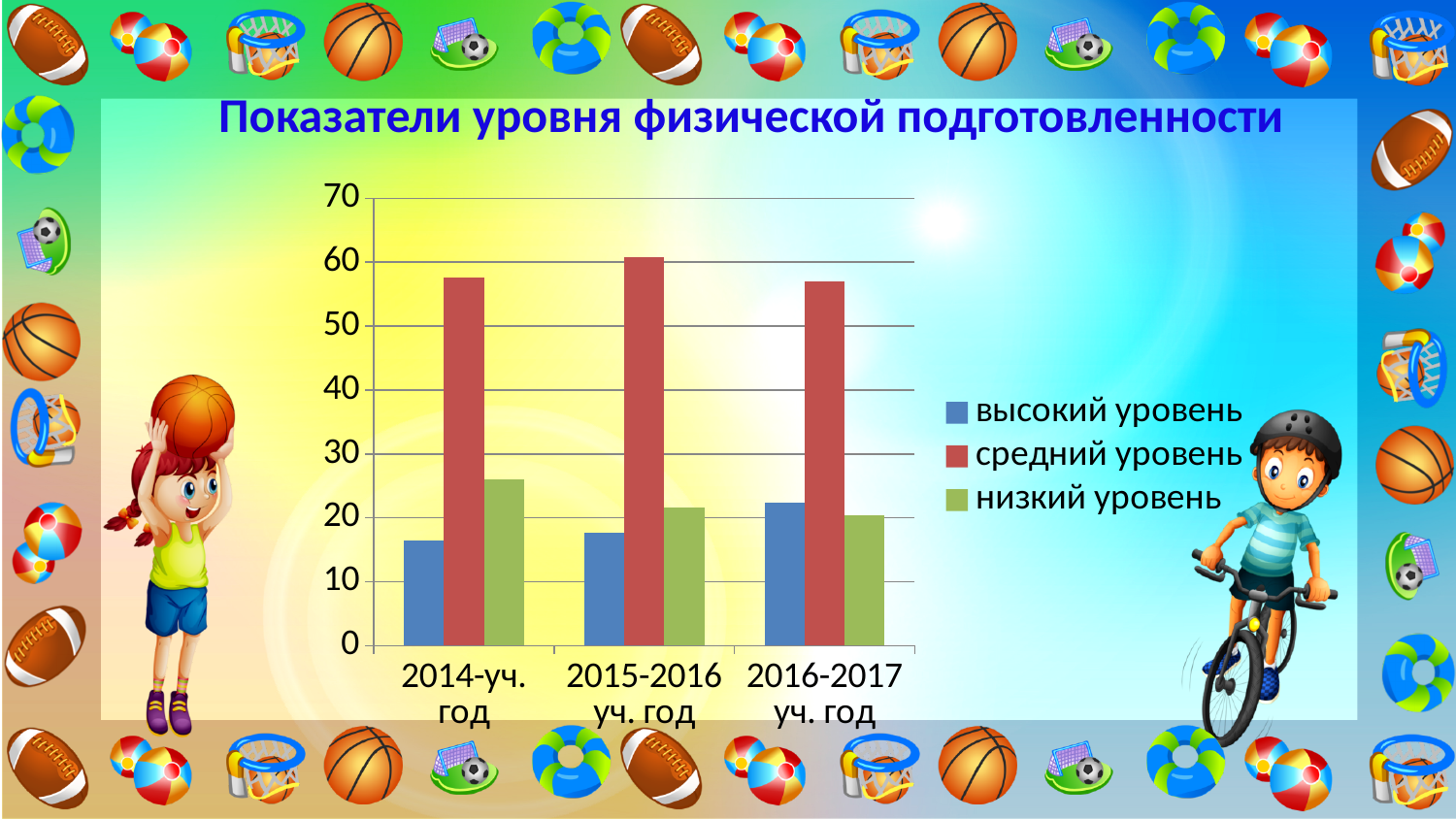
How many categories (academic years) are shown on the x axis? 3 What kind of chart is shown on the slide? bar chart Is the value for средний уровень in 2014-уч. год greater or less than 50? greater In which academic year is the value for высокий уровень the highest? 2016-2017 уч. год Is the value for низкий уровень in 2014-уч. год greater or less than 20? greater Is the value for высокий уровень in 2014-уч. год greater or less than 20? less How many series does the legend list? 3 In which academic year is the value for средний уровень the highest? 2015-2016 уч. год Does the value for высокий уровень rise or fall from 2014-уч. год to 2016-2017 уч. год? rise In which academic year is the value for низкий уровень the highest? 2014-уч. год Which is larger in 2016-2017 уч. год: средний уровень or низкий уровень? средний уровень What is the title of the chart? Показатели уровня физической подготовленности